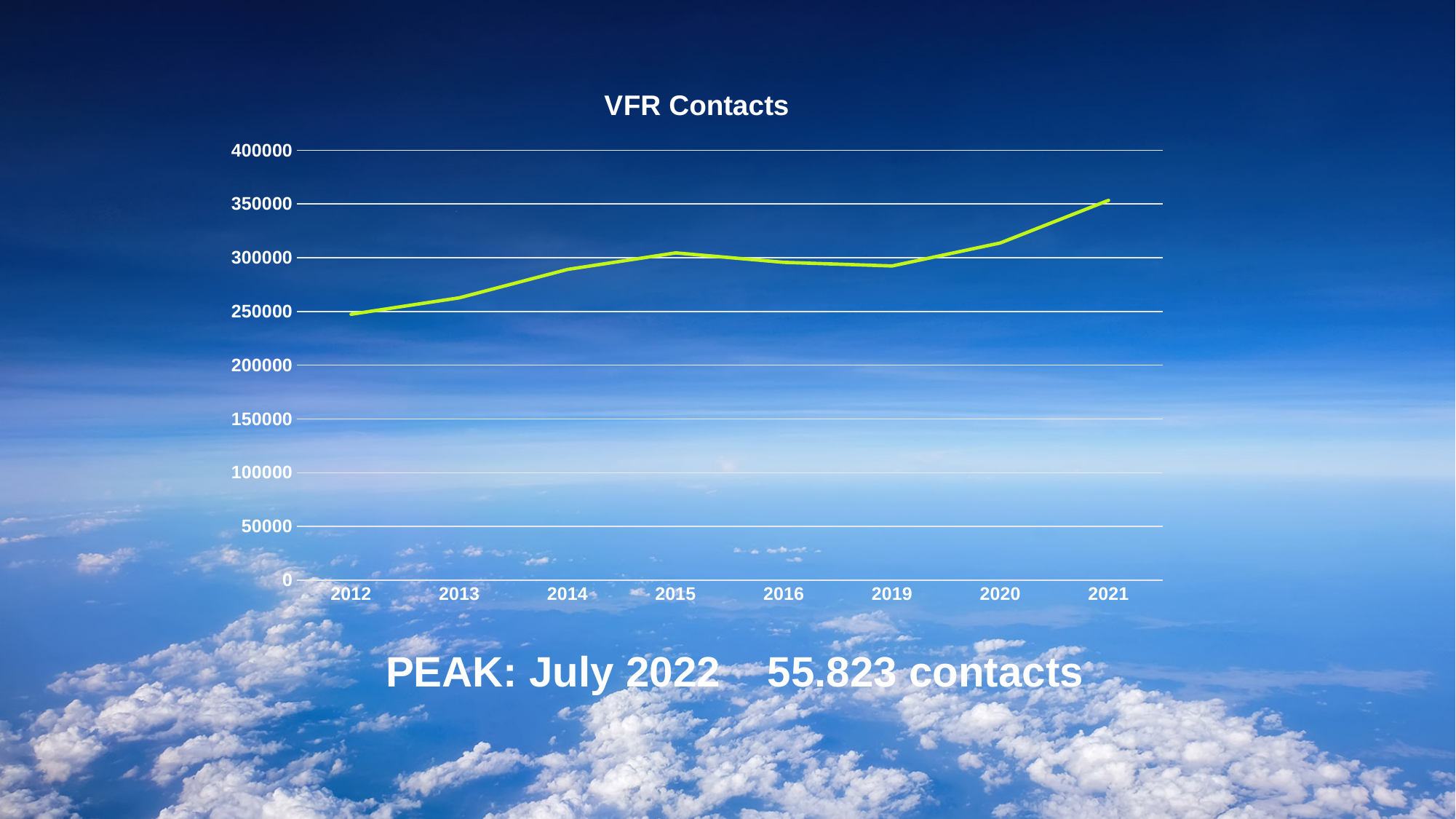
What is the title of the chart? VFR Contacts Is the value for 2019 greater or less than 300000? less Do the VFR Contacts values overall rise or fall from 2012 to 2021? rise Is the value for 2021 greater or less than 300000? greater Which year has the lowest value for VFR Contacts? 2012 What kind of chart is shown on the slide? line chart How many years are plotted on the x axis of the chart? 8 Is the value for 2013 greater or less than 250000? greater Which year has the highest value for VFR Contacts? 2021 What colour is the line in the chart? green Which year has the larger value, 2015 or 2019? 2015